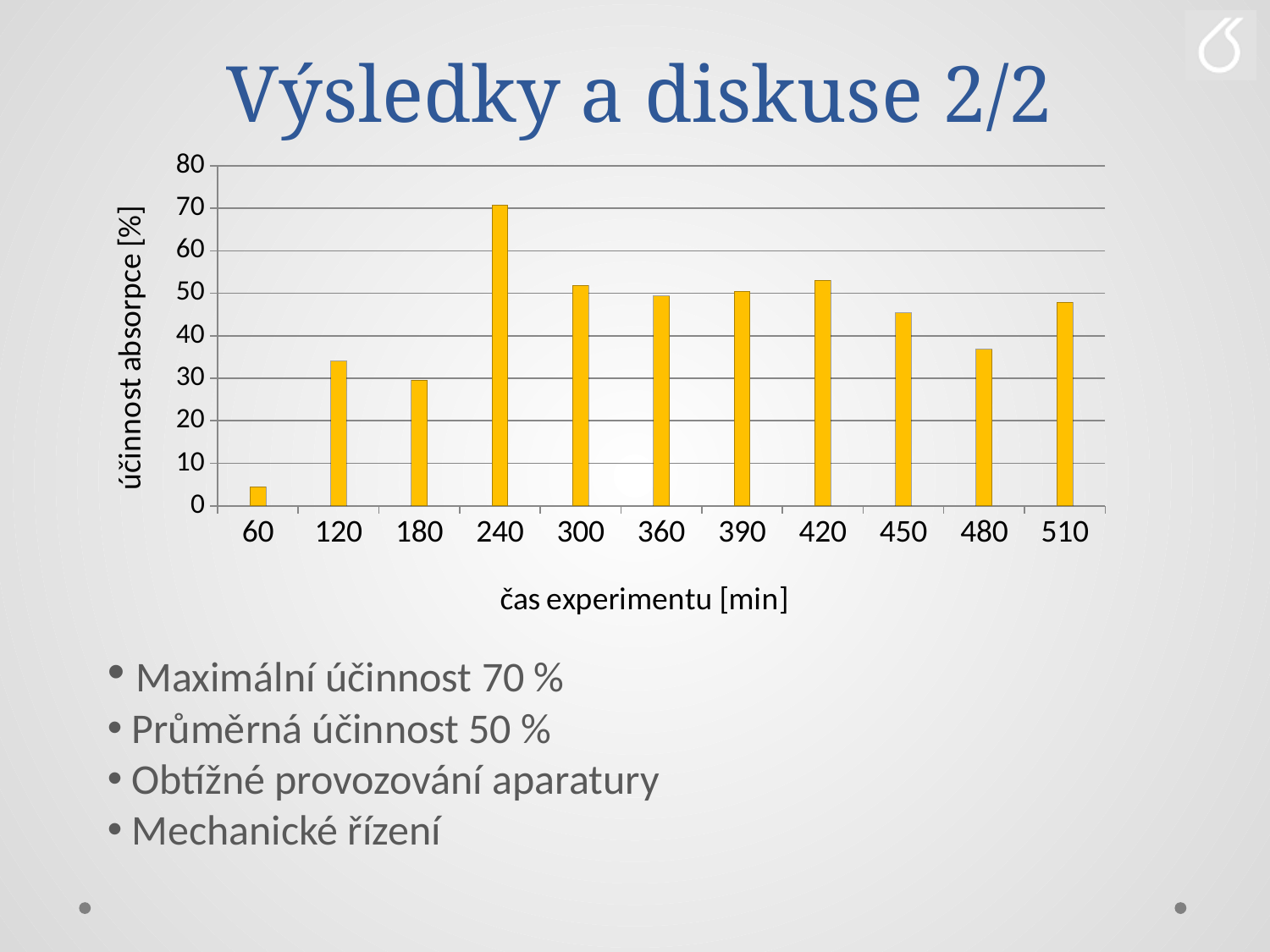
What is the label of the horizontal axis of the chart? čas experimentu [min] Which has the lower absorption efficiency, 60 min or 480 min? 60 At which experiment time is the absorption efficiency highest? 240 How many time categories are shown on the x axis of the chart? 11 Which has the higher absorption efficiency, 240 min or 120 min? 240 What kind of chart is shown on the slide? bar chart What is the label of the vertical axis of the chart? účinnost absorpce [%] Is the value for 480 min greater or less than 40? less Is the value for 60 min greater or less than 10? less Is the value for 240 min greater or less than 60? greater At which experiment time is the absorption efficiency lowest? 60